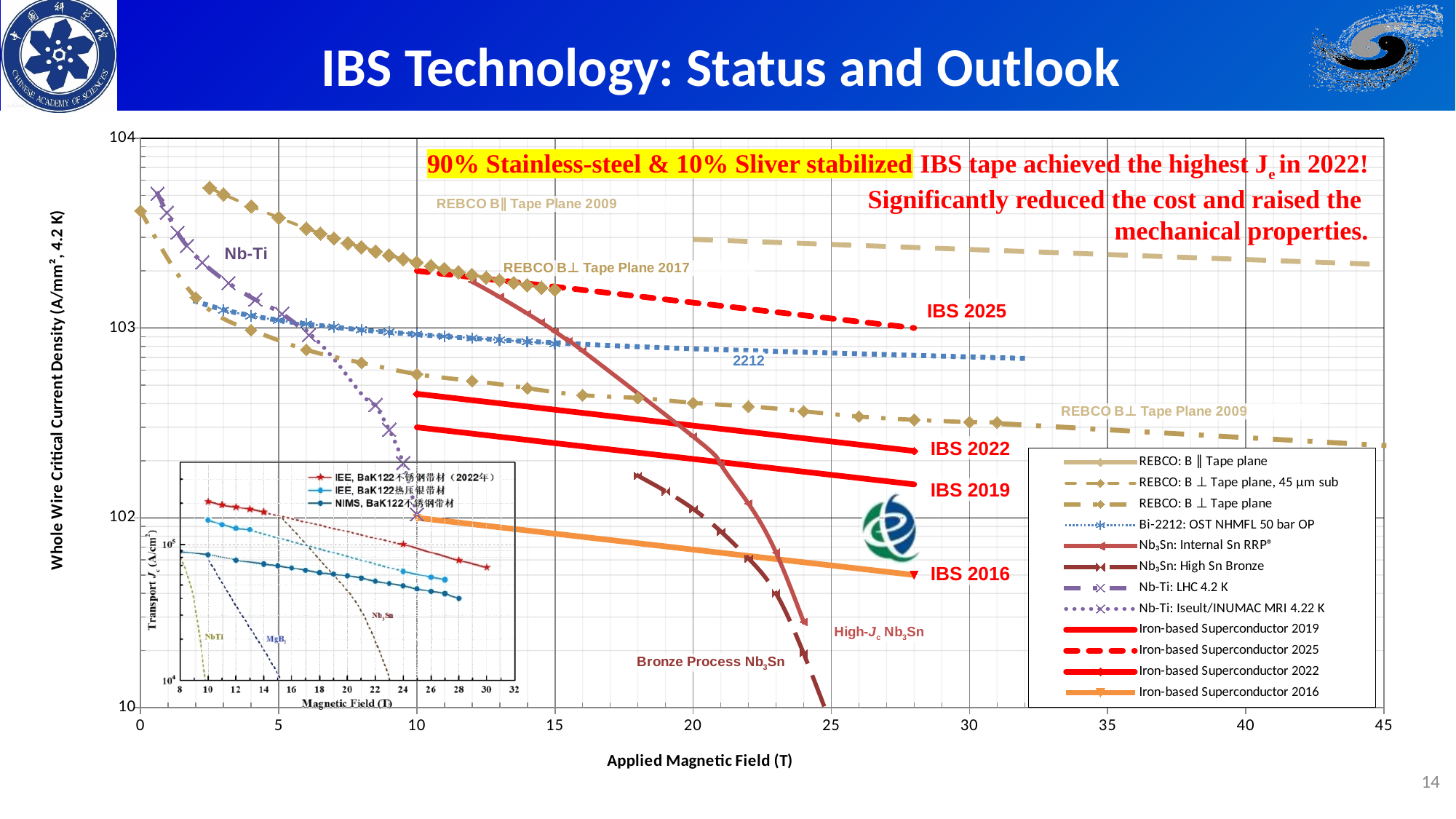
In the main chart, which is higher at 25 T: the IBS 2022 line or the IBS 2019 line? IBS 2022 How many series does the legend of the inset chart list? 3 In the main chart, is the IBS 2016 value at 28 T above or below the 10² gridline? below How many series does the legend of the main chart list? 12 In the main chart, which of the four IBS curves is the lowest? IBS 2016 In the main chart, does the IBS 2022 line rise or fall as the applied magnetic field increases? fall What kind of chart is the main chart on the slide? line chart How many IBS curves (labelled by year) are shown in the main chart? 4 In the main chart, which legend entry corresponds to the orange line? Iron-based Superconductor 2016 What kind of chart is the inset chart in the lower left? line chart What is the x-axis label of the main chart? Applied Magnetic Field (T) In the main chart, which is higher at 25 T: the IBS 2025 line or the IBS 2022 line? IBS 2025